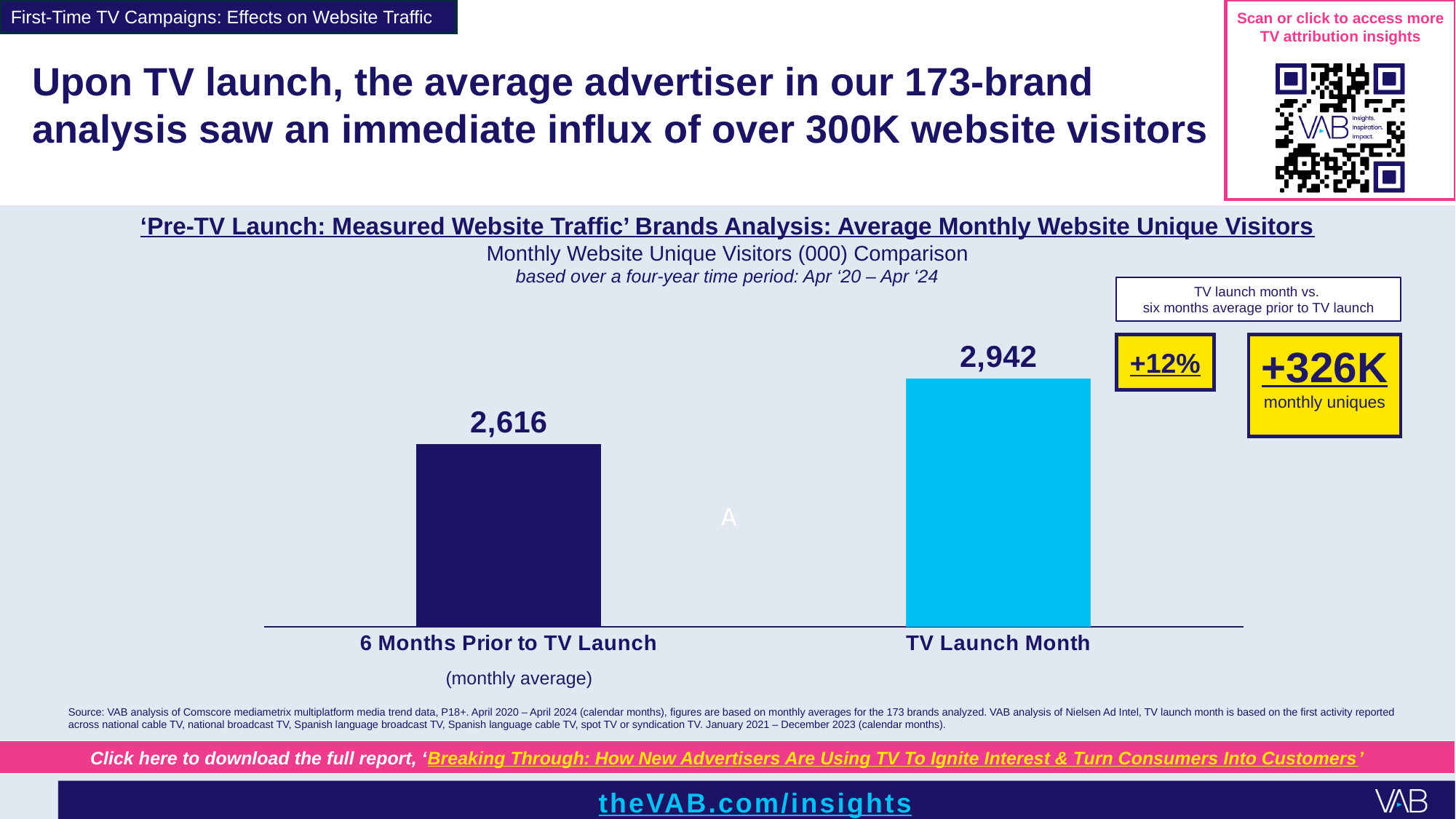
What kind of chart is shown on the slide? Bar chart What is the difference between the TV Launch Month value and the 6 Months Prior to TV Launch value? 326 What is the value for 6 Months Prior to TV Launch? 2,616 Do the values rise or fall from 6 Months Prior to TV Launch to TV Launch Month? Rise What percentage change is shown for TV launch month vs. six months average prior to TV launch? +12% How many categories are shown in the chart? 2 Which is larger: the value for TV Launch Month or the value for 6 Months Prior to TV Launch? TV Launch Month What is the value for TV Launch Month? 2,942 Which category has the lowest value? 6 Months Prior to TV Launch What is the subtitle of the chart directly below the underlined title? Monthly Website Unique Visitors (000) Comparison Which category has the highest value? TV Launch Month